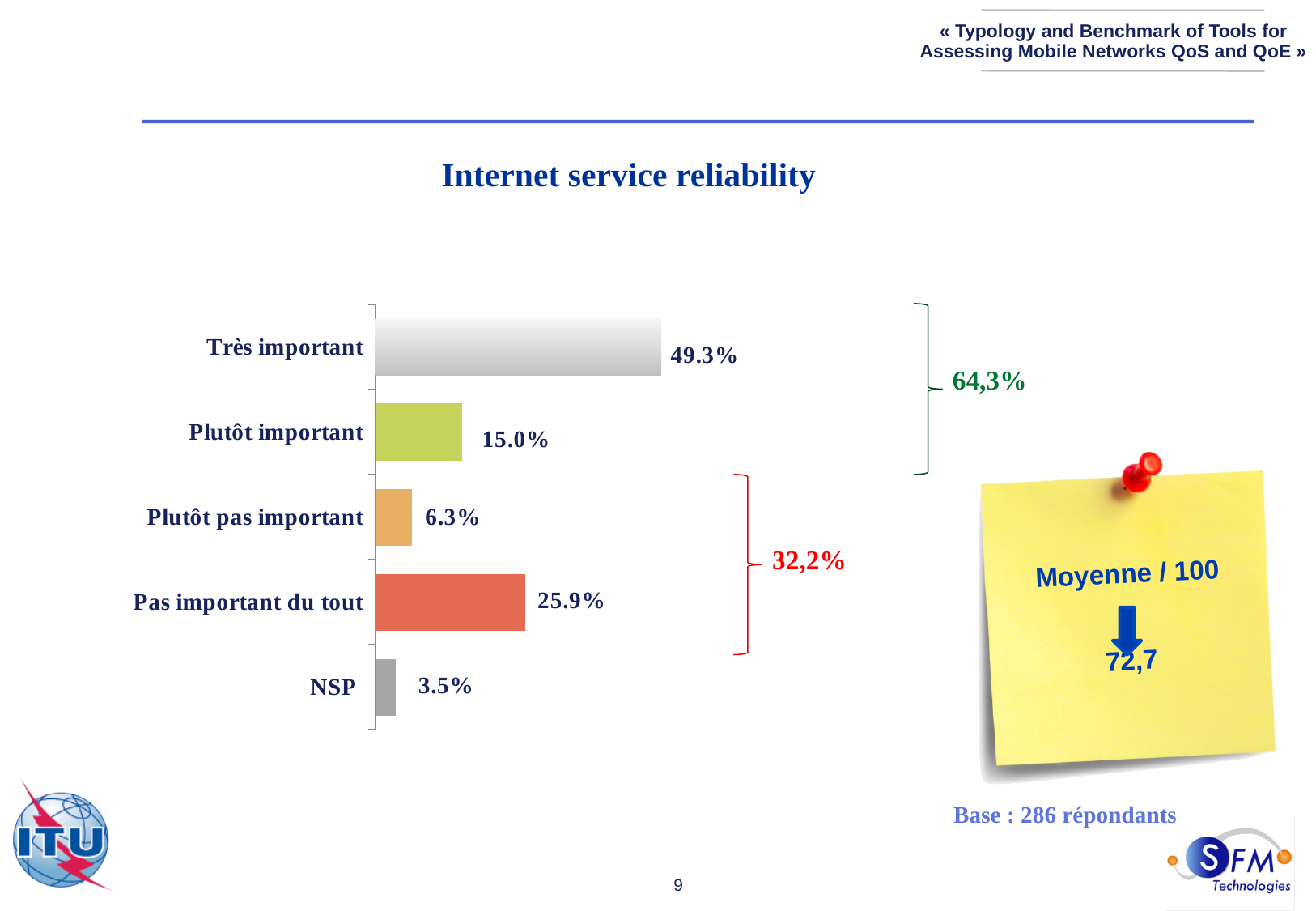
What kind of chart is shown on the slide? Bar chart What is the combined value shown by the green bracket for "Très important" and "Plutôt important"? 64,3% What is the value for "Pas important du tout"? 25.9% Which category has the lowest value? NSP Which category has the highest value? Très important What is the value for "Plutôt important"? 15.0% What is the value for "Très important"? 49.3% What is the value for "NSP"? 3.5% What is the title of the chart? Internet service reliability Which is larger, "Plutôt important" or "Plutôt pas important"? Plutôt important How many categories are shown in the chart? 5 What is the difference between "Très important" and "Pas important du tout"? 23.4%